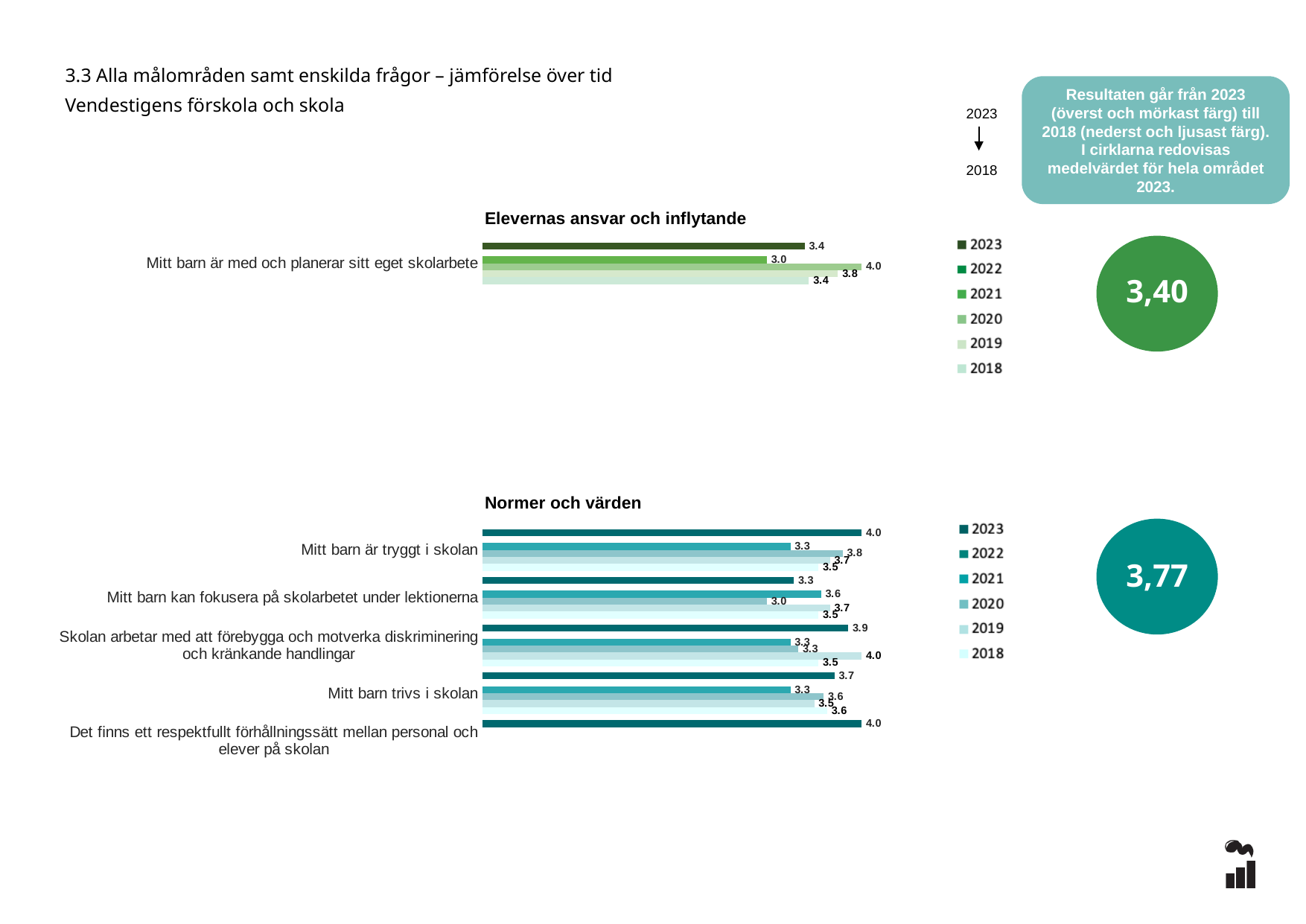
In the "Normer och värden" chart, which category has the lowest 2023 value? Mitt barn kan fokusera på skolarbetet under lektionerna In the "Elevernas ansvar och inflytande" chart, what is the 2023 value for "Mitt barn är med och planerar sitt eget skolarbete"? 3.4 In the "Normer och värden" chart, what is the difference between the 2023 values for "Mitt barn är tryggt i skolan" and "Mitt barn kan fokusera på skolarbetet under lektionerna"? 0.7 In the "Normer och värden" chart, what is the 2023 value for "Mitt barn är tryggt i skolan"? 4.0 In the "Normer och värden" chart, which has the higher 2023 value: "Mitt barn är tryggt i skolan" or "Mitt barn trivs i skolan"? Mitt barn är tryggt i skolan What type of chart is "Normer och värden"? bar chart In the "Normer och värden" chart, what is the 2023 value for "Skolan arbetar med att förebygga och motverka diskriminering och kränkande handlingar"? 3.9 In the "Elevernas ansvar och inflytande" chart, what is the highest value shown? 4.0 What mean value is shown in the circle next to the "Normer och värden" chart? 3,77 In the "Normer och värden" chart, what is the 2023 value for "Mitt barn kan fokusera på skolarbetet under lektionerna"? 3.3 In the "Normer och värden" chart, how many question categories are listed on the axis? 5 How many years does the legend of the "Normer och värden" chart list? 6